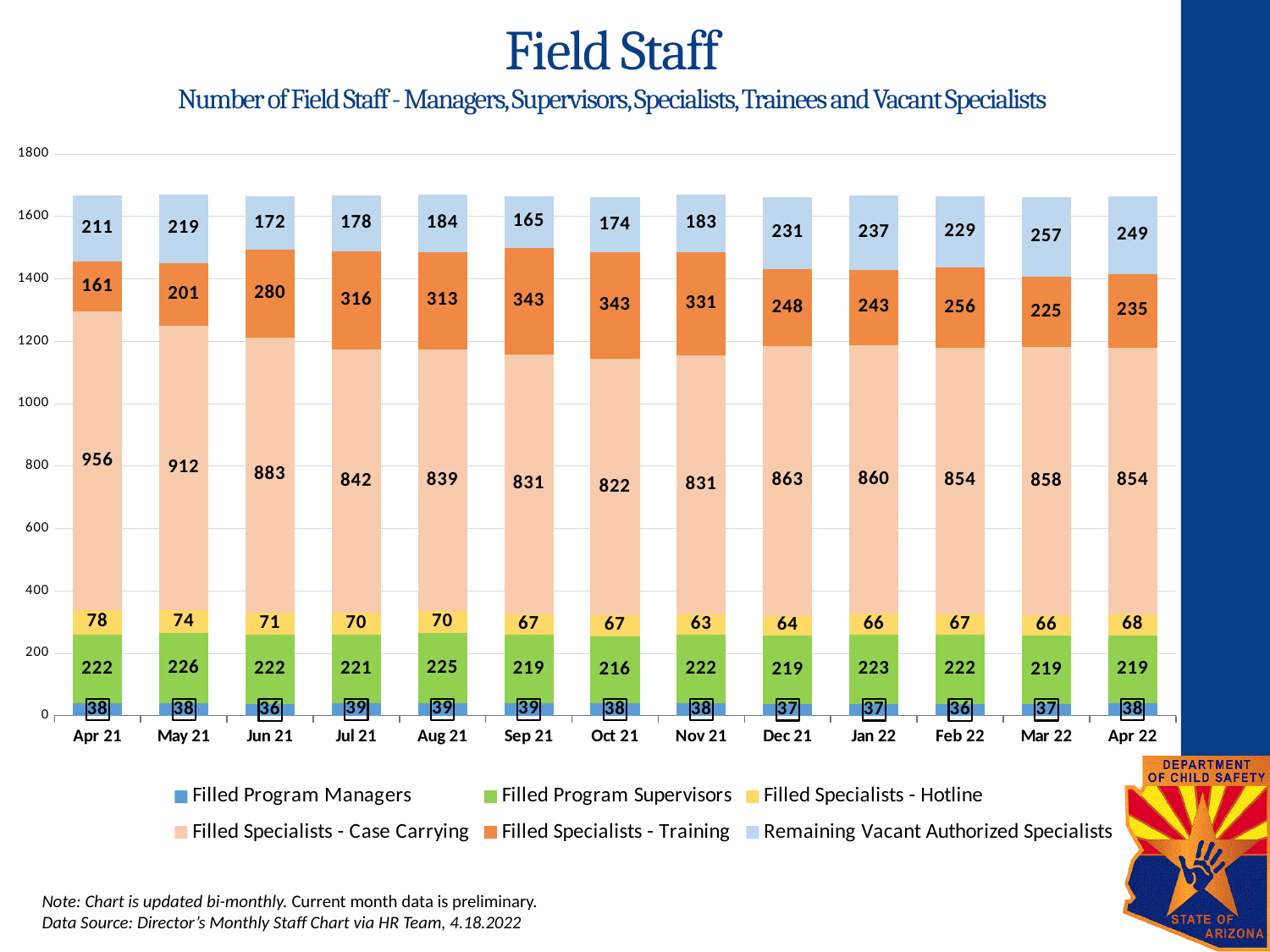
How many series does the legend list? 6 How many months are shown on the x axis? 13 What is the value for Remaining Vacant Authorized Specialists in Mar 22? 257 Which is larger, Filled Specialists - Case Carrying in Apr 21 or in Dec 21? Apr 21 What type of chart is shown on the slide? stacked bar chart What is the total of the stacked bar for Apr 22? 1663 In which month is Filled Specialists - Case Carrying lowest? Oct 21 In which month is Remaining Vacant Authorized Specialists highest? Mar 22 What is the value for Filled Specialists - Training in Sep 21? 343 What is the value for Filled Specialists - Case Carrying in Apr 21? 956 What is the value for Filled Program Managers in Jun 21? 36 What is the difference between Filled Specialists - Training in Jun 21 and May 21? 79